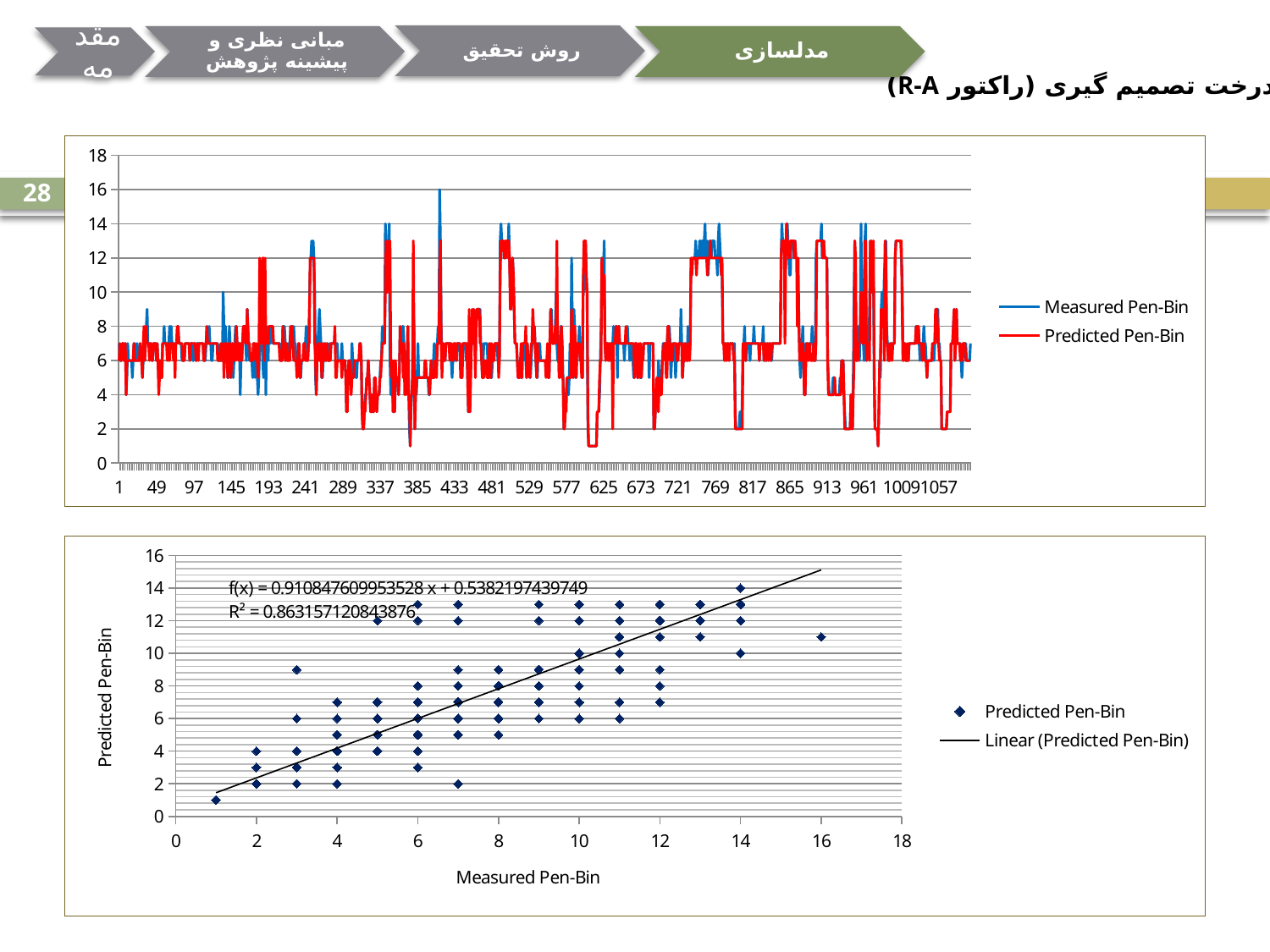
How many series does the legend of the top chart list? 2 In the top chart, which series is drawn in red? Predicted Pen-Bin How many entries does the legend of the bottom chart list? 2 In the top chart, is the lowest value of the Predicted Pen-Bin series greater or less than 2? less In the bottom chart, what is the Predicted Pen-Bin value for the point with Measured Pen-Bin equal to 16? 11 In the bottom chart, what is the R² value shown for the linear fit? 0.863157120843876 In the top chart, what is the maximum value shown on the vertical axis? 18 What kind of chart is the bottom chart on the slide? scatter chart In the bottom chart, what is the equation of the linear trendline? f(x) = 0.910847609953528 x + 0.5382197439749 In the top chart, what is the highest value reached by the Measured Pen-Bin series? 16 In the top chart, is the peak value of the Measured Pen-Bin series greater or less than 14? greater What kind of chart is the top chart on the slide? line chart